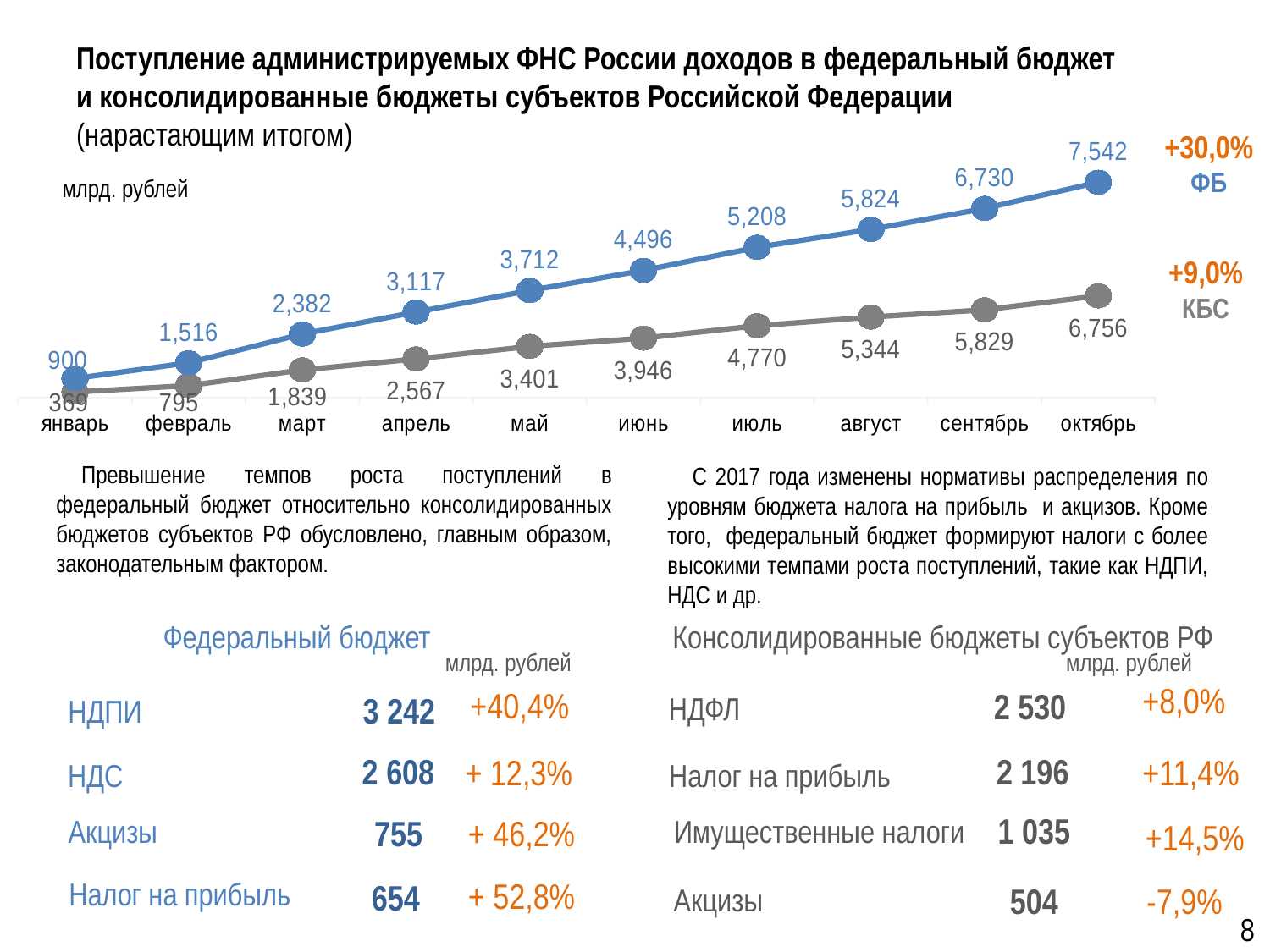
What is the difference between the ФБ and КБС values in октябрь? 786 What is the value for КБС in май? 3,401 In which month is the КБС series at its highest? октябрь What is the value for КБС in январь? 369 In which month is the ФБ series at its lowest? январь What kind of chart is shown on the slide? line chart What is the value for ФБ in октябрь? 7,542 Which is larger in июль: the ФБ value or the КБС value? ФБ Do the ФБ values rise or fall from январь to октябрь? rise How many months are plotted on the x axis? 10 How many series are plotted on the chart? 2 What is the value for ФБ in март? 2,382